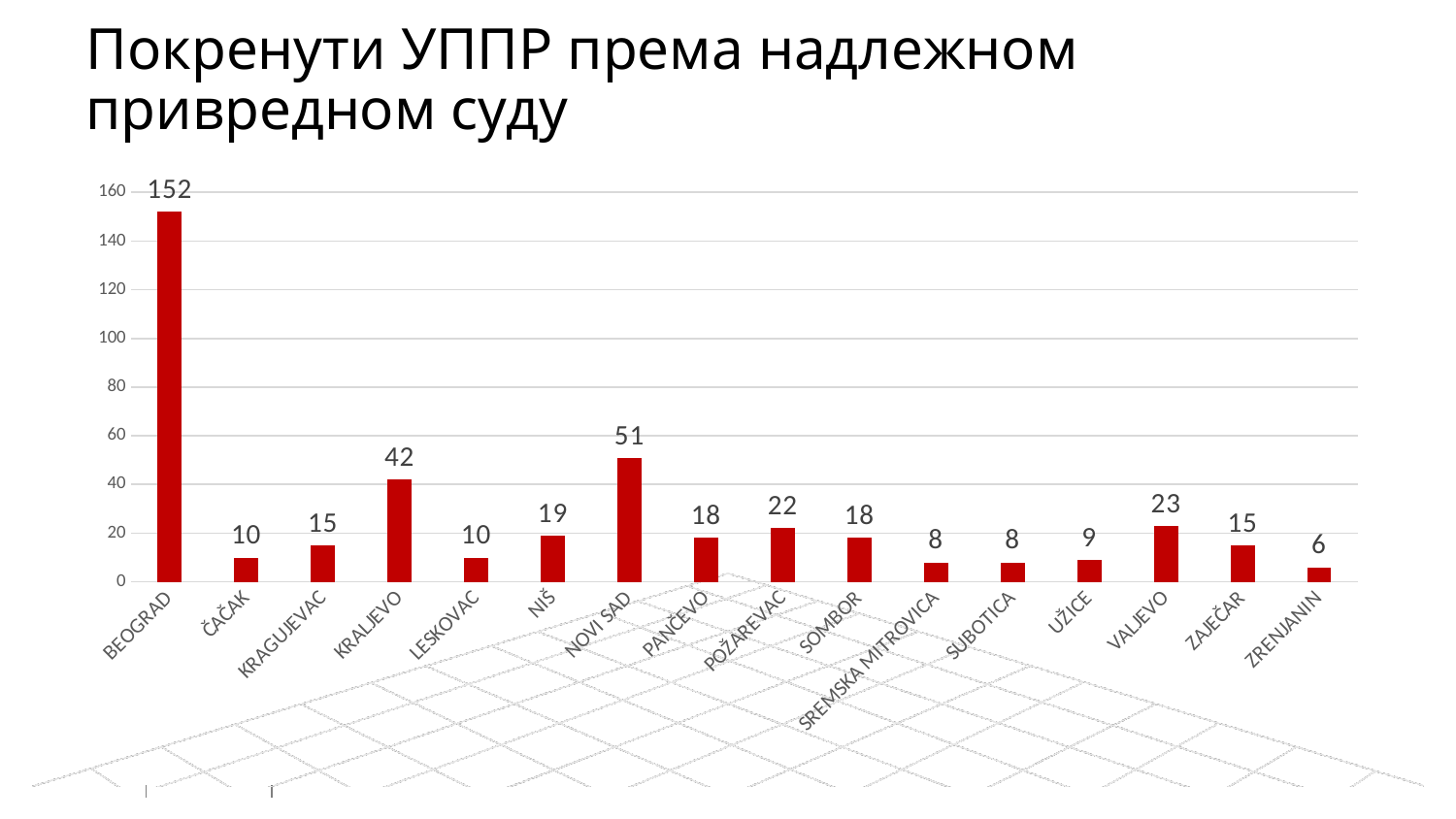
What is the value for KRALJEVO? 42 What is the value for SREMSKA MITROVICA? 8 How many categories are shown on the x axis? 16 What kind of chart is shown on the slide? bar chart Which category has the highest value? BEOGRAD Is the value for KRALJEVO greater or less than 40? greater What is the difference between the values for BEOGRAD and NOVI SAD? 101 Which is larger, the value for VALJEVO or the value for POŽAREVAC? VALJEVO What is the value for NOVI SAD? 51 What is the title of the chart? Покренути УППР према надлежном привредном суду What is the value for BEOGRAD? 152 Which category has the lowest value? ZRENJANIN